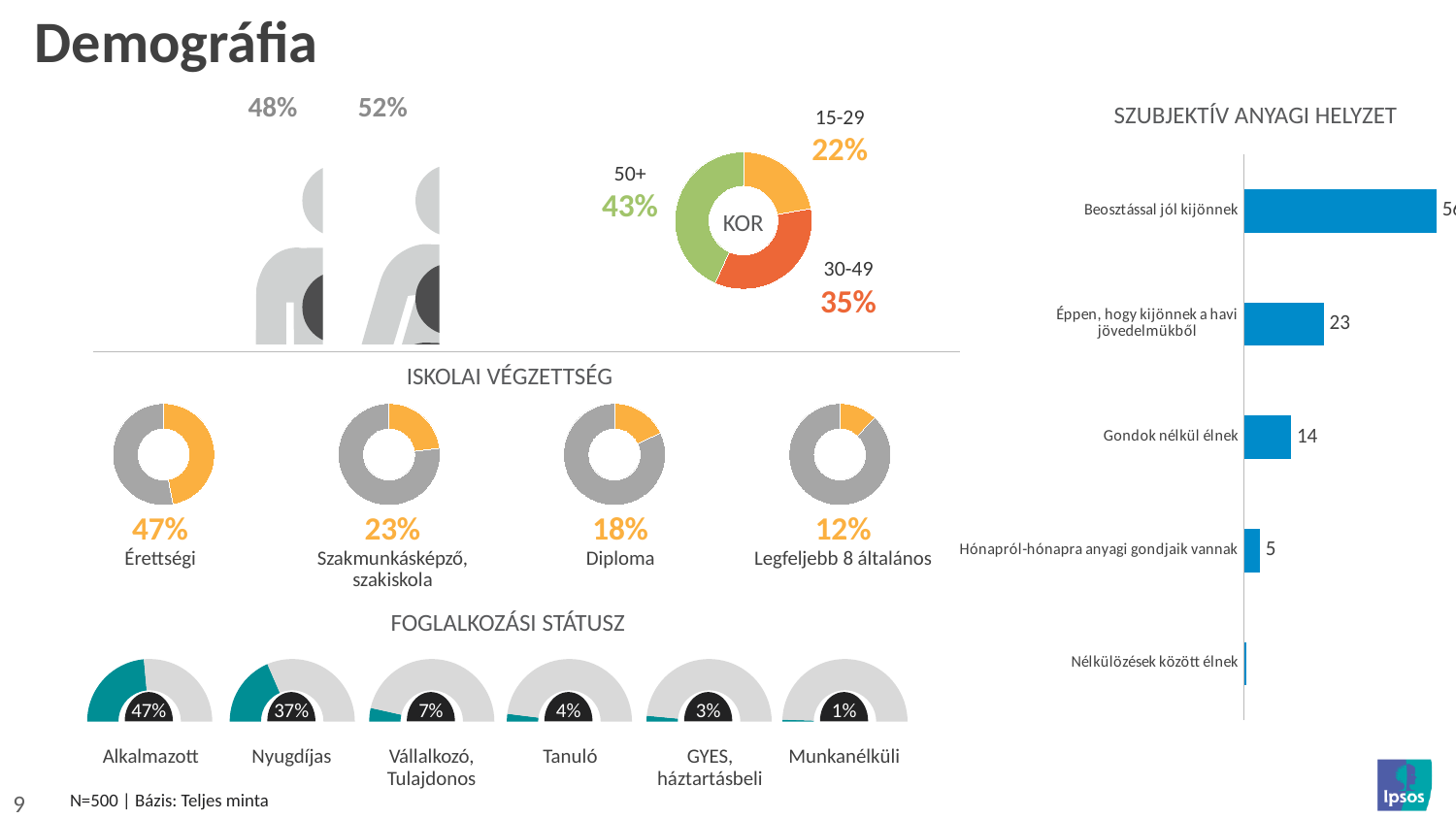
In the KOR donut chart, what share is the 15-29 age group? 22% In the FOGLALKOZÁSI STÁTUSZ section, how many categories are shown? 6 In the SZUBJEKTÍV ANYAGI HELYZET bar chart, what is the difference between Éppen, hogy kijönnek a havi jövedelmükből and Hónapról-hónapra anyagi gondjaik vannak? 18 In the FOGLALKOZÁSI STÁTUSZ section, what percentage is shown for Nyugdíjas? 37% In the KOR donut chart, what share is the 30-49 age group? 35% In the SZUBJEKTÍV ANYAGI HELYZET bar chart, what is the value for Gondok nélkül élnek? 14 In the ISKOLAI VÉGZETTSÉG section, what percentage is shown for Diploma? 18% In the ISKOLAI VÉGZETTSÉG section, which category has the lowest percentage? Legfeljebb 8 általános In the KOR donut chart, how many age groups are shown? 3 What kind of chart is the SZUBJEKTÍV ANYAGI HELYZET chart? Bar chart In the KOR donut chart, which age group has the largest share? 50+ In the KOR donut chart, what is the difference between the 50+ share and the 15-29 share? 21 percentage points